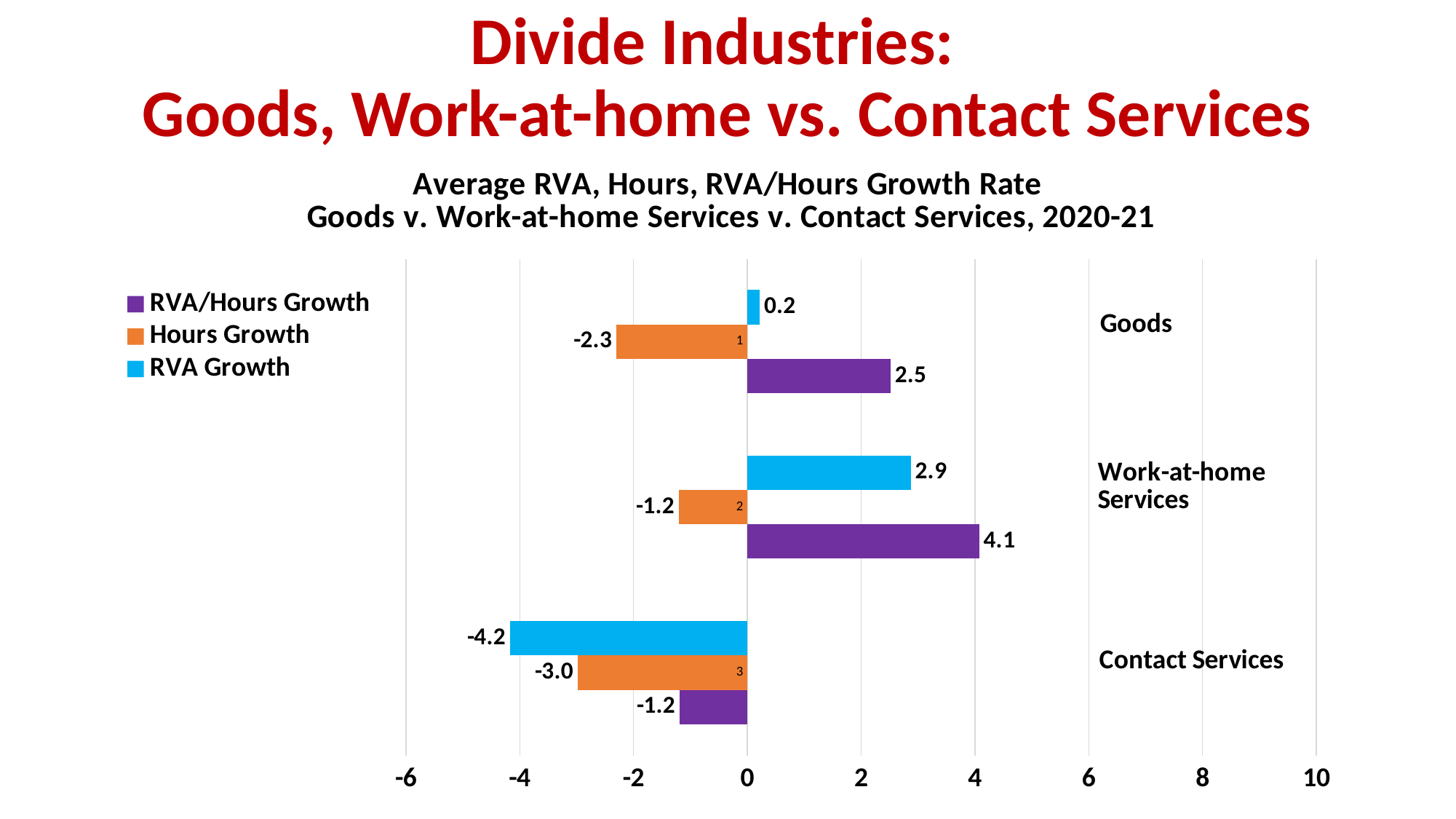
What is the Hours Growth value for Goods? -2.3 Which category has the highest RVA/Hours Growth? Work-at-home Services Which category has the lowest RVA Growth? Contact Services What is the RVA Growth value for Contact Services? -4.2 What is the difference between the RVA/Hours Growth for Work-at-home Services and for Goods? 1.6 What is the RVA/Hours Growth value for Work-at-home Services? 4.1 Which is larger, the RVA Growth for Work-at-home Services or the RVA/Hours Growth for Goods? RVA Growth for Work-at-home Services How many series does the legend list? 3 What kind of chart is shown on the slide? Bar chart How many categories are shown on the chart? 3 Which colour represents Hours Growth in the chart? Orange What is the RVA Growth value for Goods? 0.2